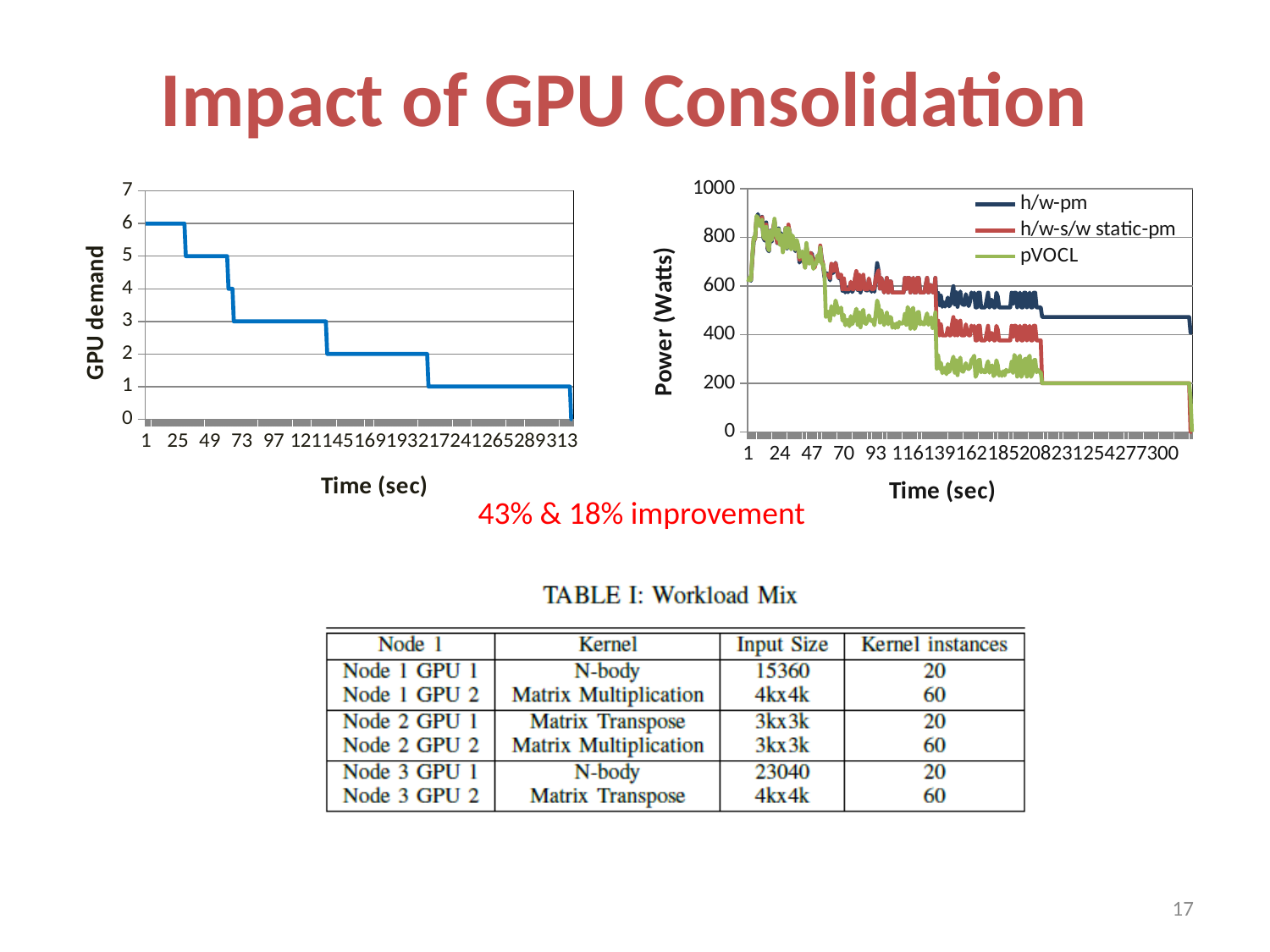
What kind of chart is the left chart showing GPU demand? line chart In the left chart, does GPU demand rise or fall as time increases? fall In the left chart, what is the GPU demand at time 145? 2 In the right chart, which series has the lowest power between time 139 and 208? pVOCL What kind of chart is the right chart showing Power (Watts)? line chart In the right chart, which series has the highest power between time 139 and 208? h/w-pm In the left chart, what is the GPU demand at time 265? 1 In the right chart, is the h/w-pm power at time 254 greater or less than 400? greater In the right chart, is the pVOCL power at time 254 greater or less than 400? less In the left chart, what is the highest value shown on the GPU demand axis? 7 In the left chart, what is the GPU demand at the start (time 1)? 6 How many series does the legend of the right chart (Power vs Time) list? 3